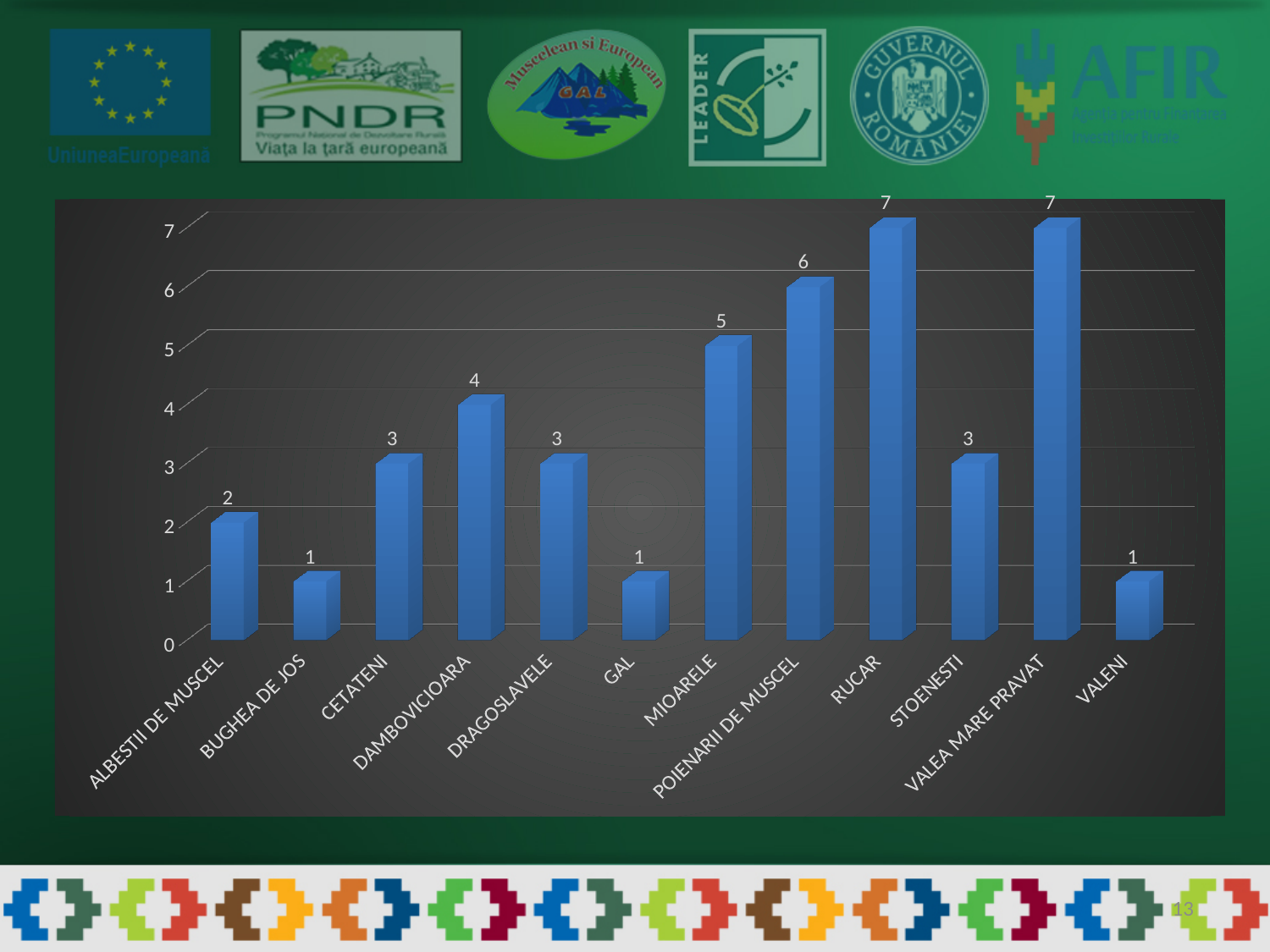
How many categories are shown on the x axis? 12 What is the difference between the values for POIENARII DE MUSCEL and GAL? 5 What is the value for DAMBOVICIOARA? 4 What is the value for ALBESTII DE MUSCEL? 2 What is the difference between the values for RUCAR and CETATENI? 4 What is the value for STOENESTI? 3 What is the value for POIENARII DE MUSCEL? 6 What kind of chart is shown on the slide? Bar chart Which categories have the highest value? RUCAR and VALEA MARE PRAVAT What is the value for MIOARELE? 5 Which is larger, the value for MIOARELE or the value for DRAGOSLAVELE? MIOARELE Which categories have the lowest value? BUGHEA DE JOS, GAL and VALENI